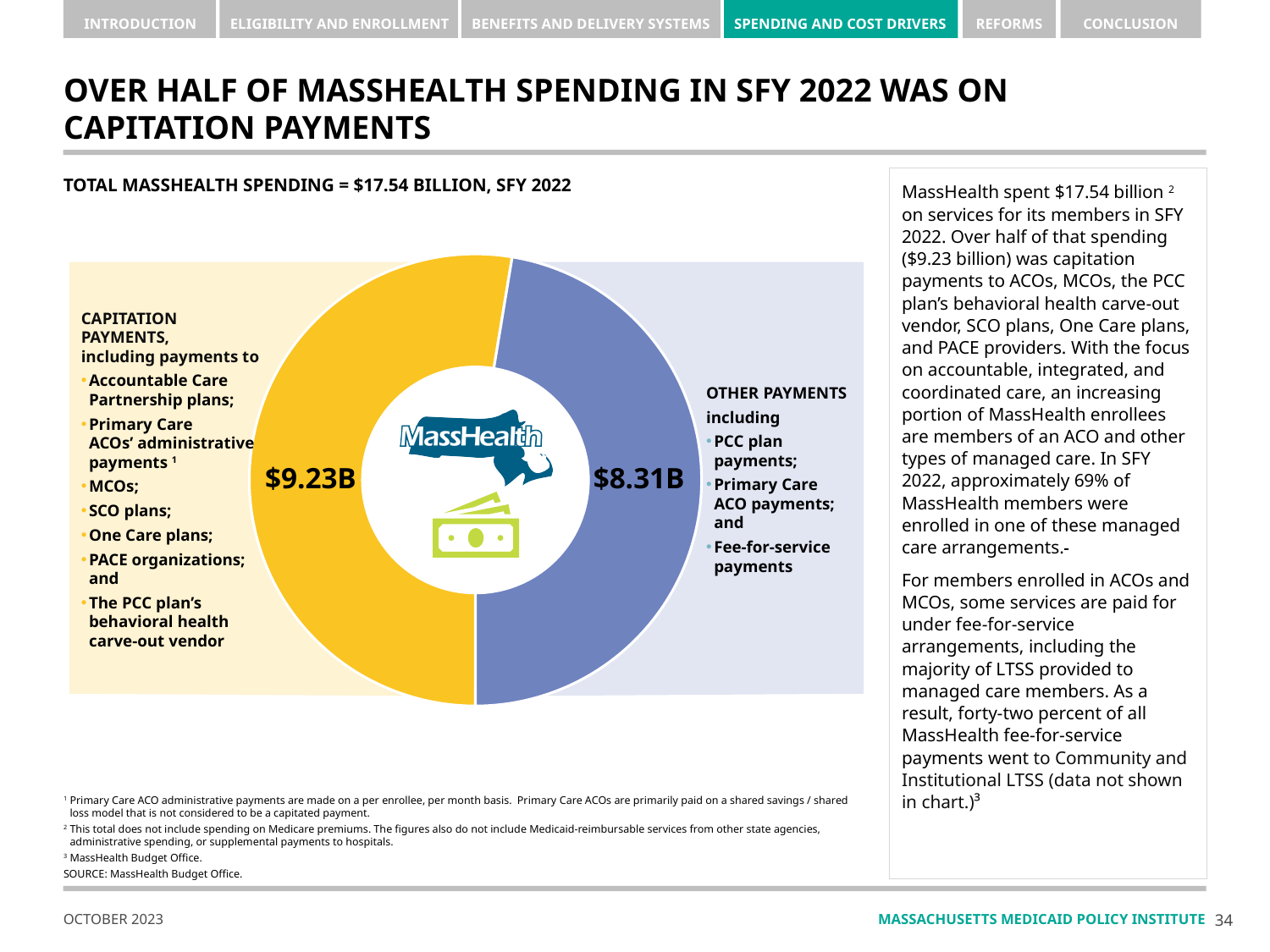
How many slices does the chart have? 2 What is the difference between Capitation Payments and Other Payments? $0.92B What is the value shown for Other Payments? $8.31B Which slice of the chart is the largest? Capitation Payments Which is larger, Capitation Payments or Other Payments? Capitation Payments What kind of chart is shown on the slide? pie chart What is the total MassHealth spending shown for SFY 2022? $17.54 billion What is the title of the chart? TOTAL MASSHEALTH SPENDING = $17.54 BILLION, SFY 2022 What is the value shown for Capitation Payments? $9.23B What colour is the Capitation Payments slice? yellow Which slice of the chart is the smallest? Other Payments